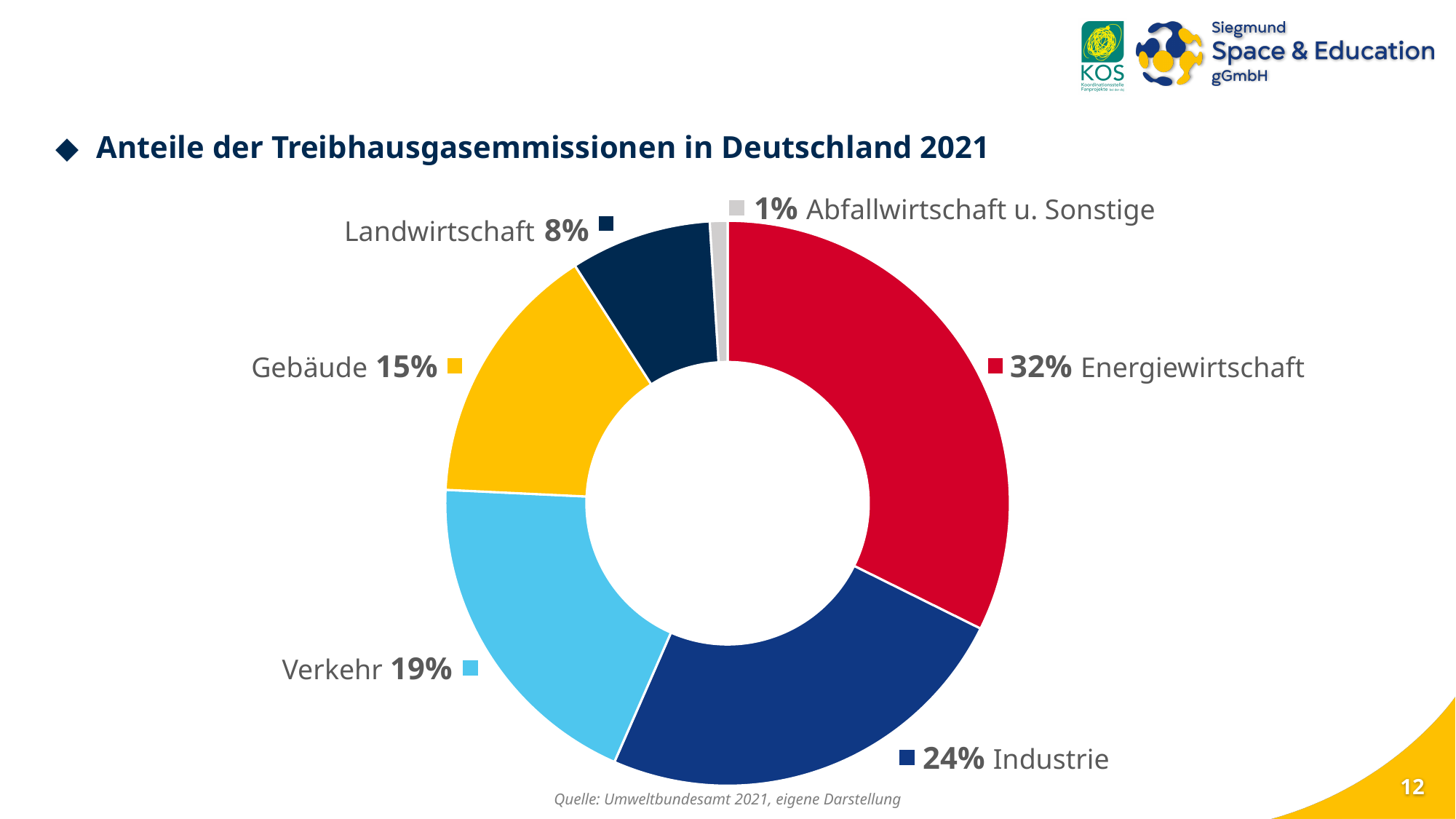
What share of greenhouse gas emissions does Landwirtschaft account for? 8% How many sectors are shown in the chart? 6 What share of greenhouse gas emissions does Verkehr account for? 19% What share of greenhouse gas emissions does Industrie account for? 24% What share of greenhouse gas emissions does Gebäude account for? 15% What type of chart is shown on the slide? Pie chart (donut) Which sector has the largest share of greenhouse gas emissions? Energiewirtschaft Which sector has the smallest share of greenhouse gas emissions? Abfallwirtschaft u. Sonstige What is the difference in percentage points between the shares of Energiewirtschaft and Industrie? 8 What share of greenhouse gas emissions does Energiewirtschaft account for? 32% Which sector has a larger share, Verkehr or Gebäude? Verkehr What is the title of the chart? Anteile der Treibhausgasemmissionen in Deutschland 2021